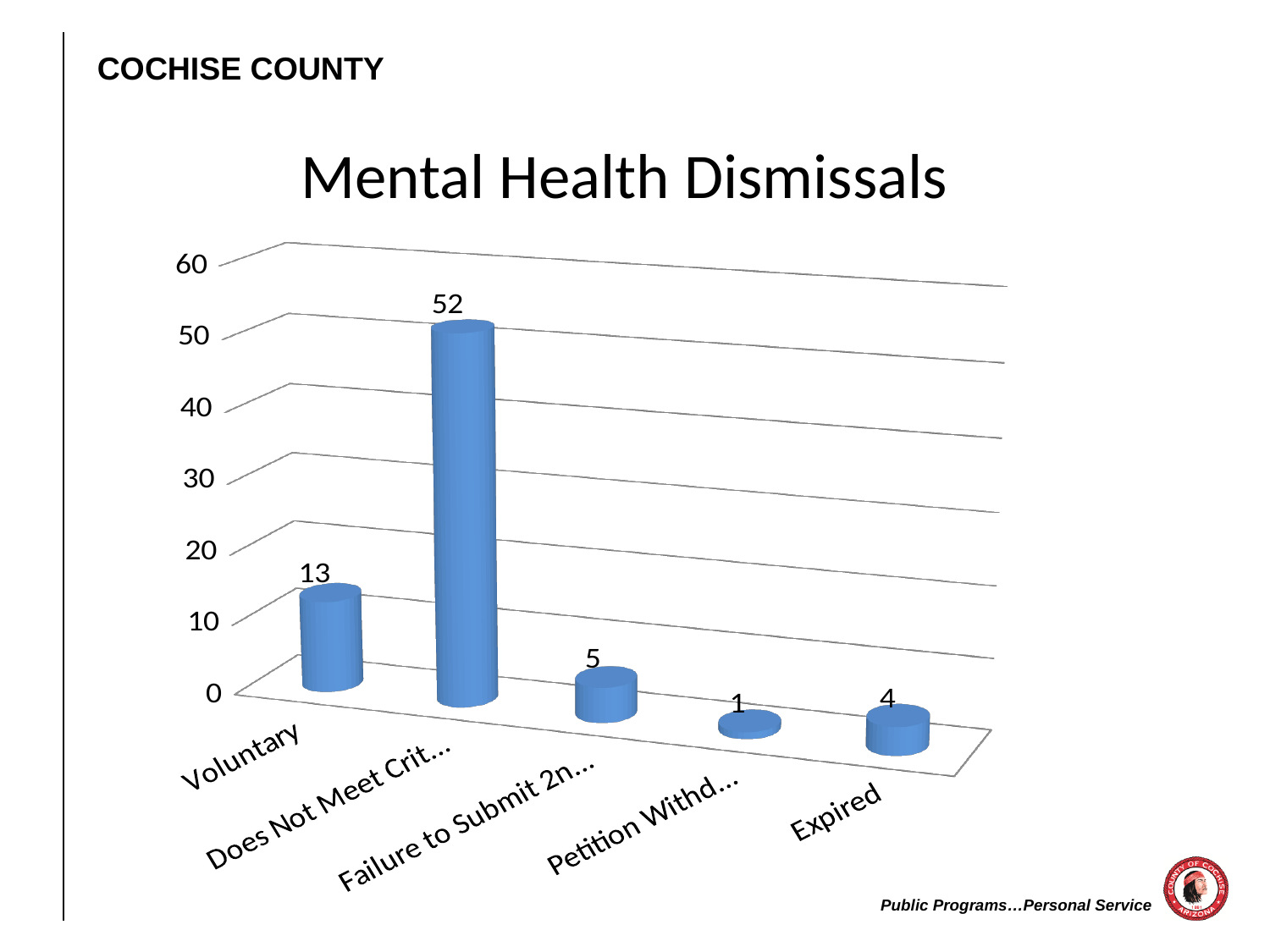
What kind of chart is shown on the slide? bar chart Which category has the highest value? Does Not Meet Crit... How many categories are shown on the x axis? 5 What is the value for Voluntary? 13 What is the difference between the values for Does Not Meet Crit... and Voluntary? 39 What is the title of the chart? Mental Health Dismissals Is the value for Does Not Meet Crit... greater or less than 50? greater Which is larger, the value for Voluntary or the value for Expired? Voluntary Which category has the lowest value? Petition Withd... What is the highest value shown on the vertical axis? 60 What is the value for Expired? 4 What is the value for the category labelled "Failure to Submit 2n..."? 5